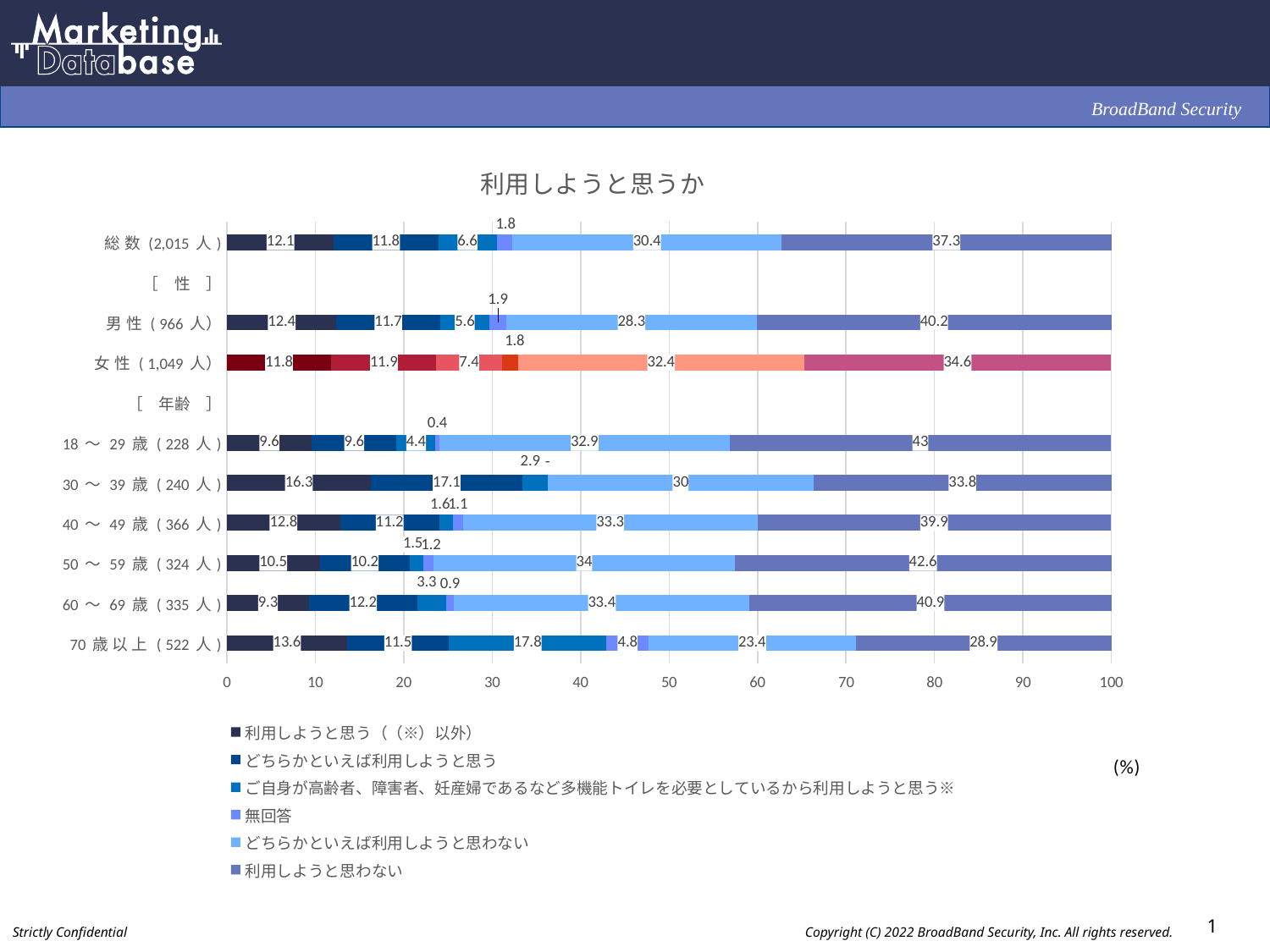
How many categories have bars plotted in the chart? 9 What is the value for 利用しようと思わない in the 総数 (2,015人) bar? 37.3 How many series does the legend list? 6 Which is larger for どちらかといえば利用しようと思わない, 男性 or 女性? 女性 What is the difference between 男性 and 女性 for 利用しようと思わない? 5.6 What is the title of the chart? 利用しようと思うか What is the value for ご自身が高齢者、障害者、妊産婦であるなど多機能トイレを必要としているから利用しようと思う※ in the 70歳以上 (522人) bar? 17.8 Which category has the lowest value for 利用しようと思わない? 70歳以上 (522人) What is the value for 無回答 in the 18〜29歳 (228人) bar? 0.4 What is the value for 利用しようと思う（（※）以外） in the 30〜39歳 (240人) bar? 16.3 Which category has the highest value for 利用しようと思わない? 18〜29歳 (228人) What kind of chart is shown on the slide? Stacked bar chart